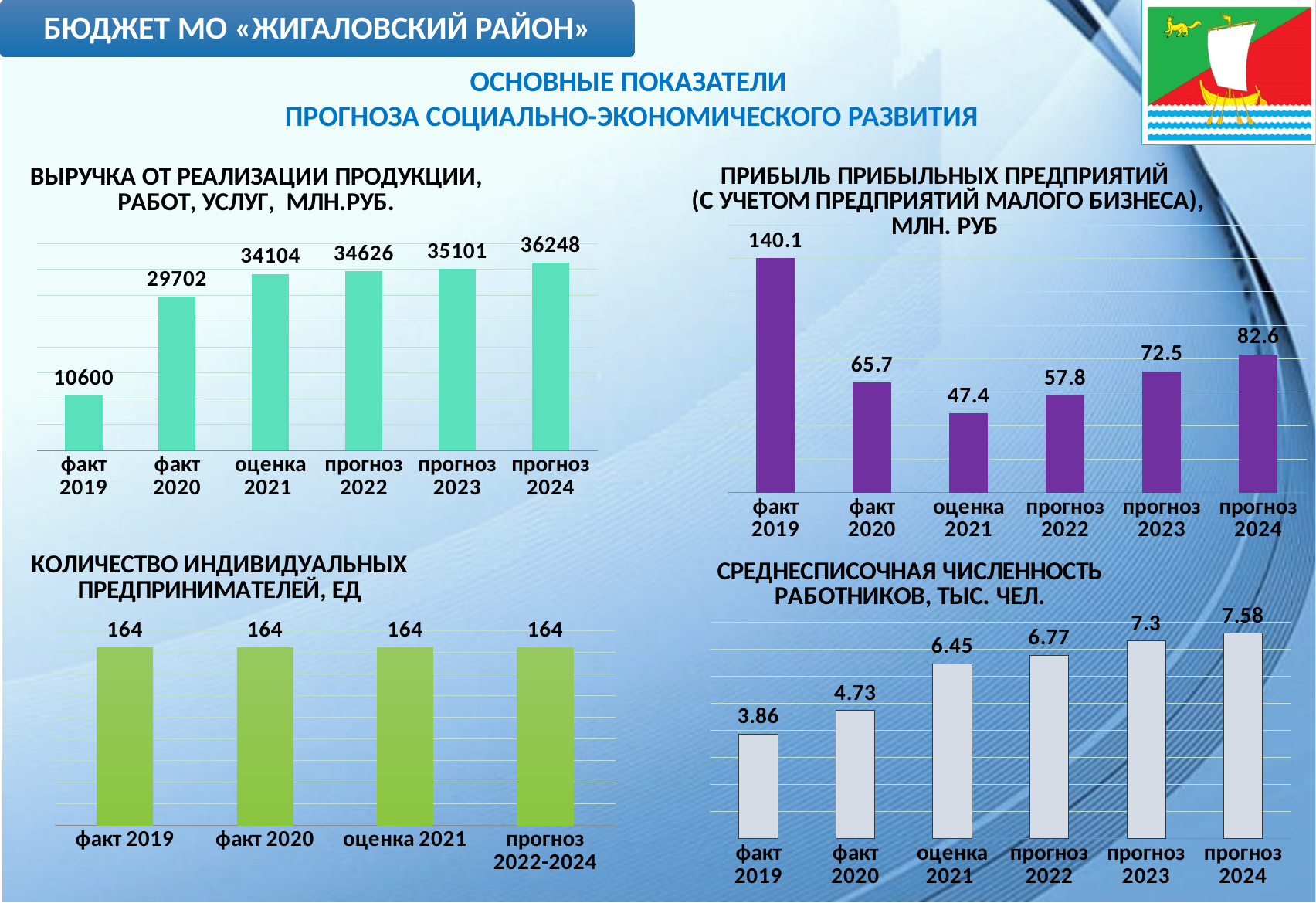
What type of chart is the bottom-right chart (Среднесписочная численность работников)? bar chart In the top-right chart (Прибыль прибыльных предприятий), which is larger: прогноз 2022 or факт 2020? факт 2020 In the bottom-left chart (Количество индивидуальных предпринимателей), what is the value for оценка 2021? 164 In the top-left chart (Выручка от реализации продукции, работ, услуг), what is the value for факт 2020? 29702 In the top-left chart (Выручка от реализации продукции, работ, услуг), what is the difference between прогноз 2024 and прогноз 2023? 1147 How many bars are in the bottom-left chart (Количество индивидуальных предпринимателей)? 4 In the bottom-right chart (Среднесписочная численность работников), what is the value for прогноз 2023? 7.3 In the top-left chart (Выручка от реализации продукции, работ, услуг), do the values rise or fall from факт 2019 to прогноз 2024? rise In the top-right chart (Прибыль прибыльных предприятий), what is the difference between факт 2019 and факт 2020? 74.4 In the top-left chart (Выручка от реализации продукции, работ, услуг), which category has the lowest value? факт 2019 In the top-right chart (Прибыль прибыльных предприятий), what is the value for оценка 2021? 47.4 In the top-right chart (Прибыль прибыльных предприятий), which category has the highest value? факт 2019